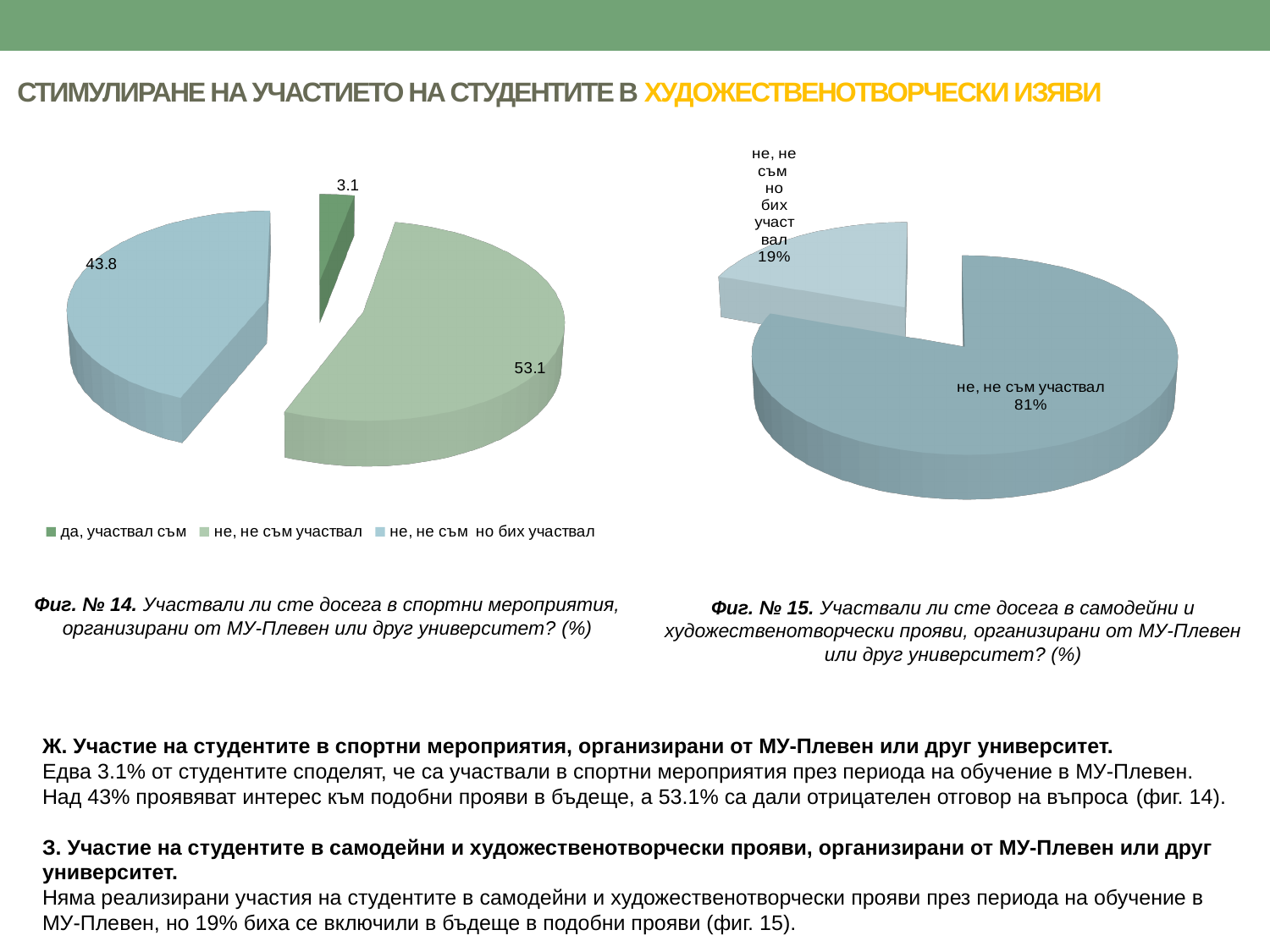
In the left pie chart (Фиг. № 14), what is the value for "не, не съм но бих участвал"? 43.8 In the left pie chart (Фиг. № 14), how many categories does the legend list? 3 In the left pie chart (Фиг. № 14), what is the value for "не, не съм участвал"? 53.1 In the left pie chart (Фиг. № 14), which category has the smallest slice? да, участвал съм In the right pie chart (Фиг. № 15), how many slices are shown? 2 In the left pie chart (Фиг. № 14), which category has the largest slice? не, не съм участвал In the right pie chart (Фиг. № 15), what is the share for "не, не съм но бих участвал"? 19% In the right pie chart (Фиг. № 15), what is the share for "не, не съм участвал"? 81% In the left pie chart (Фиг. № 14), what is the difference between the values for "не, не съм участвал" and "не, не съм но бих участвал"? 9.3 In the right pie chart (Фиг. № 15), which of the two slices is larger: "не, не съм участвал" or "не, не съм но бих участвал"? не, не съм участвал What type of chart is used for Фиг. № 14 on the left of the slide? Pie chart In the left pie chart (Фиг. № 14), what is the value for "да, участвал съм"? 3.1